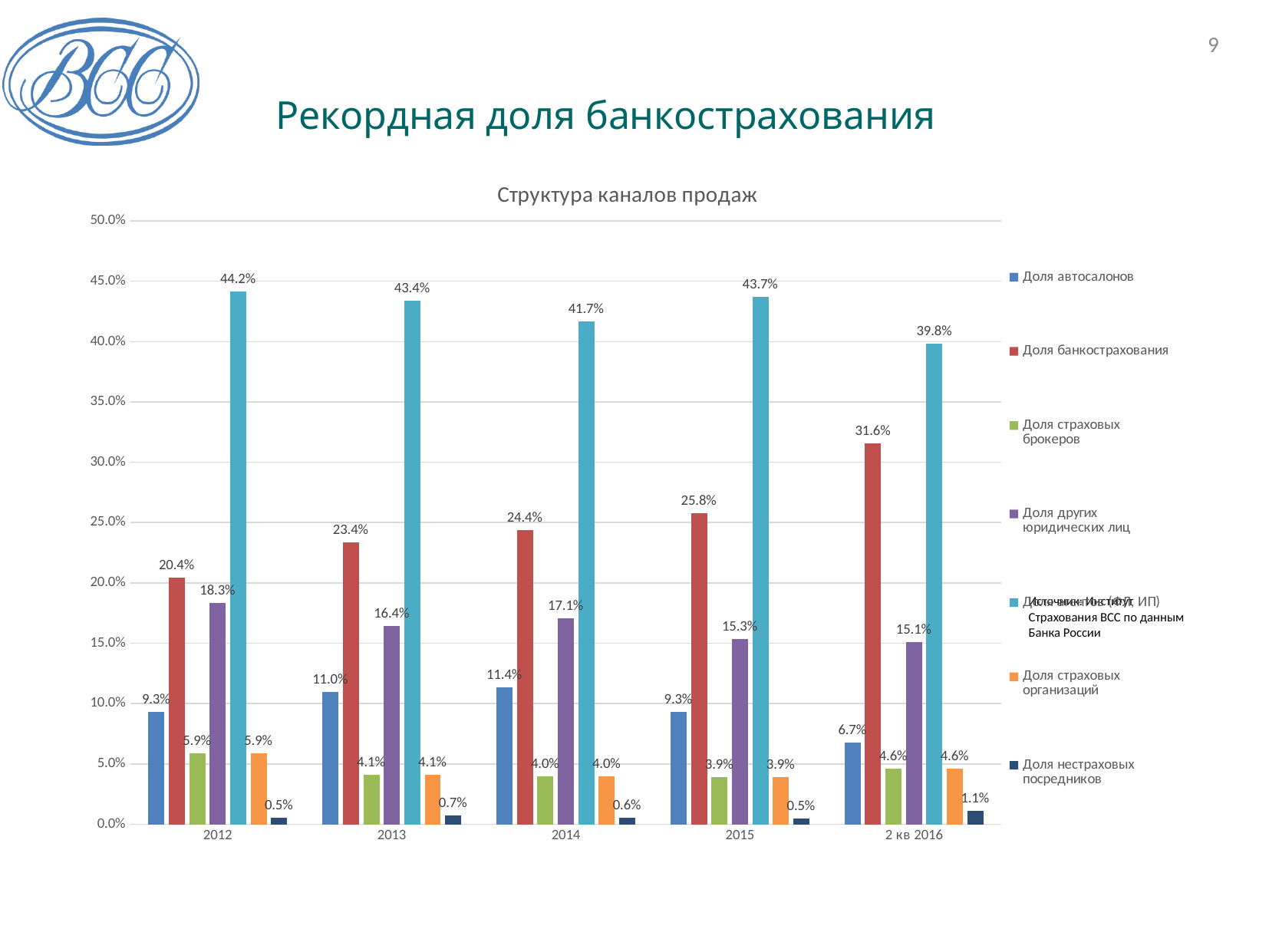
How many series does the chart legend list? 7 What is the value of Доля банкострахования for 2 кв 2016? 31.6% What type of chart is shown on the slide? bar chart Which is larger: Доля других юридических лиц in 2012 or in 2013? 2012 What is the value of Доля других юридических лиц for 2014? 17.1% In which category is Доля банкострахования highest? 2 кв 2016 What is the value of Доля автосалонов for 2013? 11.0% What is the title of the chart? Структура каналов продаж In which category is Доля автосалонов lowest? 2 кв 2016 How many categories are shown on the x axis of the chart? 5 What is the difference between Доля банкострахования in 2 кв 2016 and in 2015? 5.8% Does Доля банкострахования rise or fall from 2012 to 2 кв 2016? rise